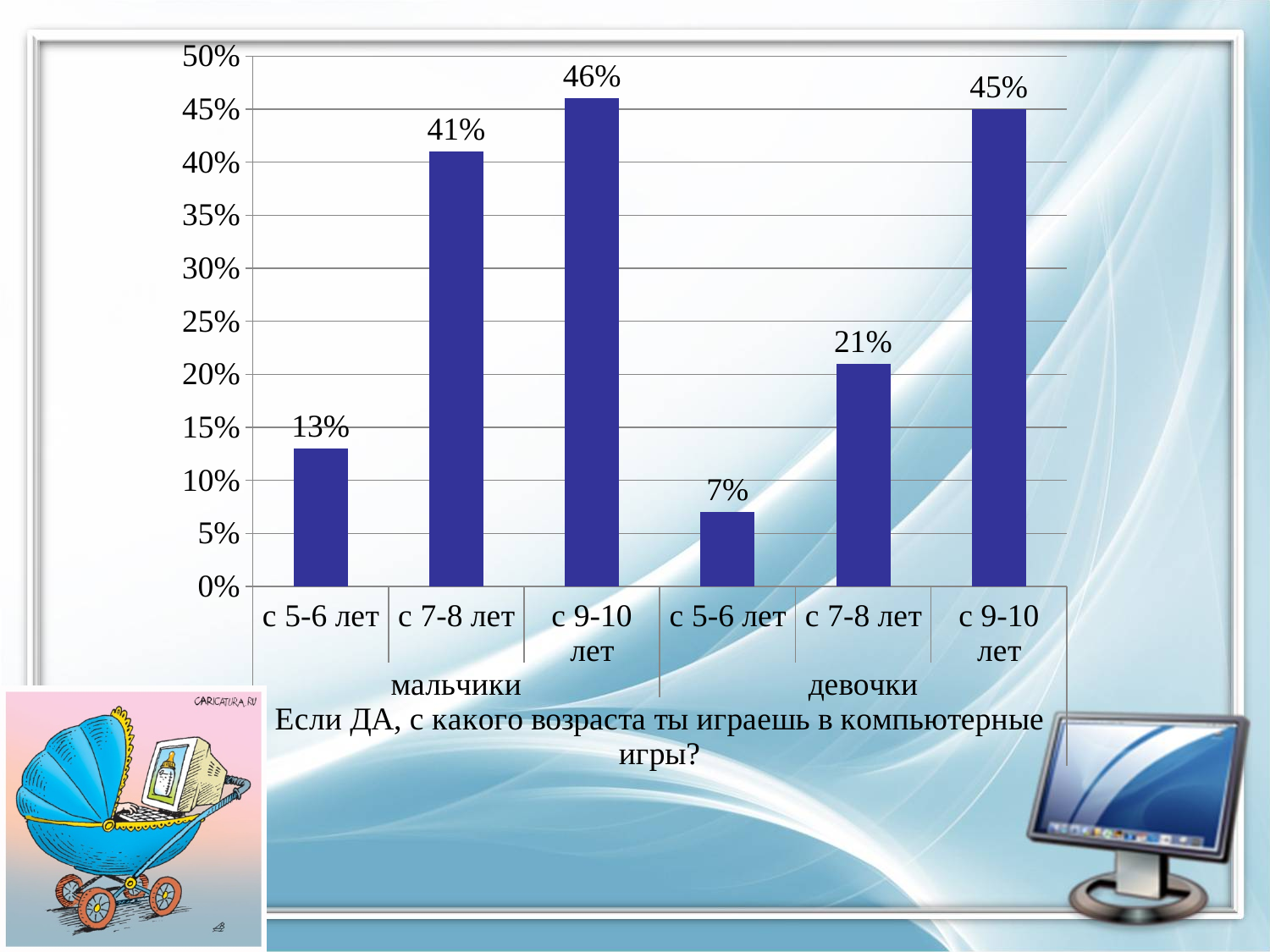
Is the value for girls at 7-8 years greater or less than 25%? less Which is larger: the boys' 9-10 years value or the girls' 9-10 years value? boys' 9-10 years (46%) What is the value for girls (девочки) who started playing at 9-10 years (с 9-10 лет)? 45% How many bars are plotted on the chart? 6 What is the title of the chart? Если ДА, с какого возраста ты играешь в компьютерные игры? What is the difference between the boys' 7-8 years value and the girls' 7-8 years value? 20% Which bar has the highest value on the chart? мальчики, с 9-10 лет (46%) What is the value for boys (мальчики) who started playing at 5-6 years (с 5-6 лет)? 13% What is the difference between the boys' 5-6 years value and the girls' 5-6 years value? 6% What is the value for girls (девочки) who started playing at 7-8 years (с 7-8 лет)? 21% What kind of chart is shown on the slide? bar chart Which bar has the lowest value on the chart? девочки, с 5-6 лет (7%)